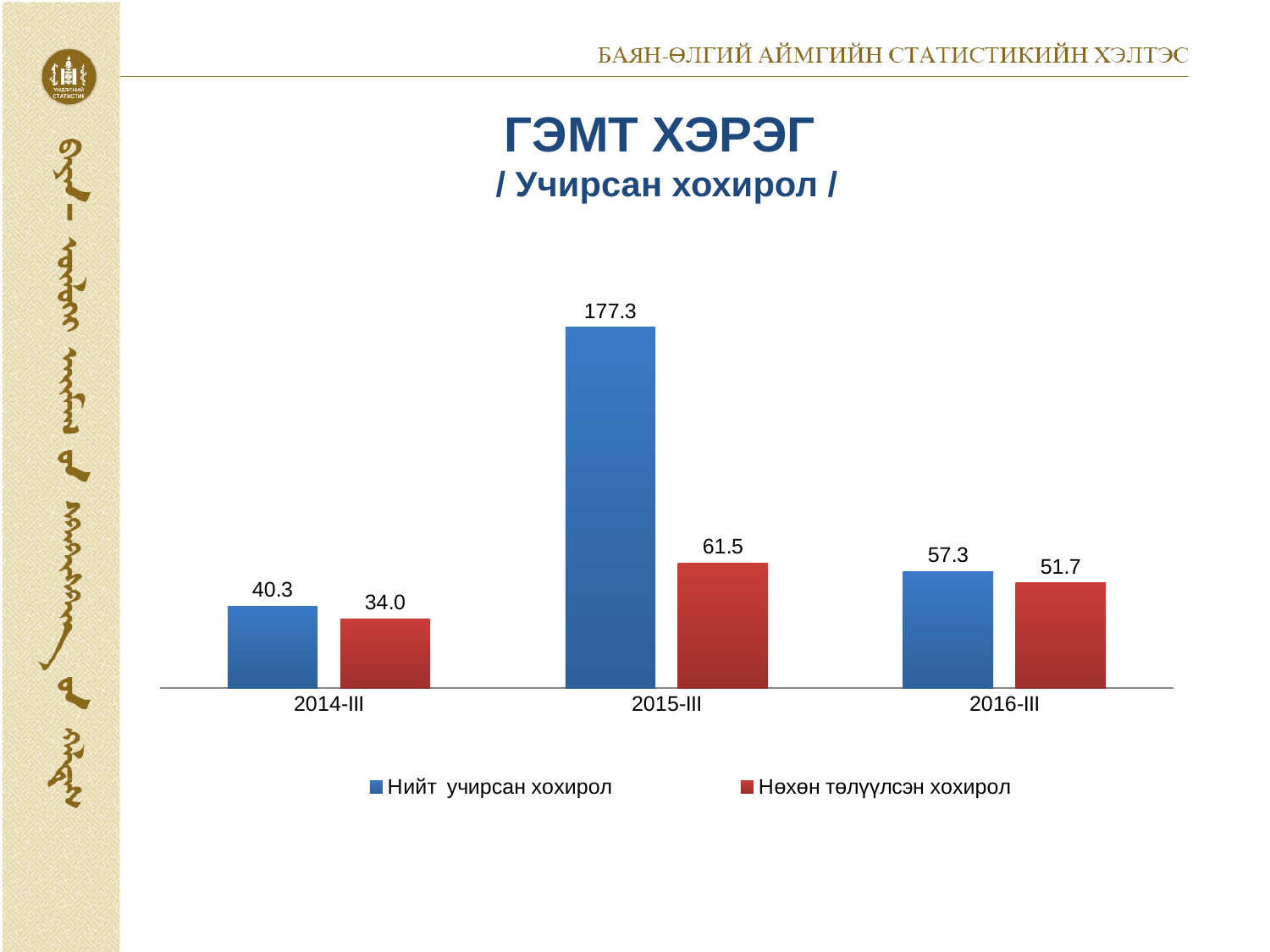
In which period is Нийт учирсан хохирол highest? 2015-III In which period is Нөхөн төлүүлсэн хохирол lowest? 2014-III What is the value of Нийт учирсан хохирол for 2016-III? 57.3 How many periods are shown on the x axis? 3 What is the value of Нийт учирсан хохирол for 2015-III? 177.3 What is the value of Нөхөн төлүүлсэн хохирол for 2016-III? 51.7 What is the difference between Нийт учирсан хохирол in 2015-III and in 2016-III? 120.0 How many series does the legend list? 2 What kind of chart is shown on the slide? Bar chart What is the difference between Нийт учирсан хохирол and Нөхөн төлүүлсэн хохирол in 2015-III? 115.8 Which is larger: Нөхөн төлүүлсэн хохирол in 2015-III or in 2016-III? 2015-III What is the value of Нөхөн төлүүлсэн хохирол for 2014-III? 34.0